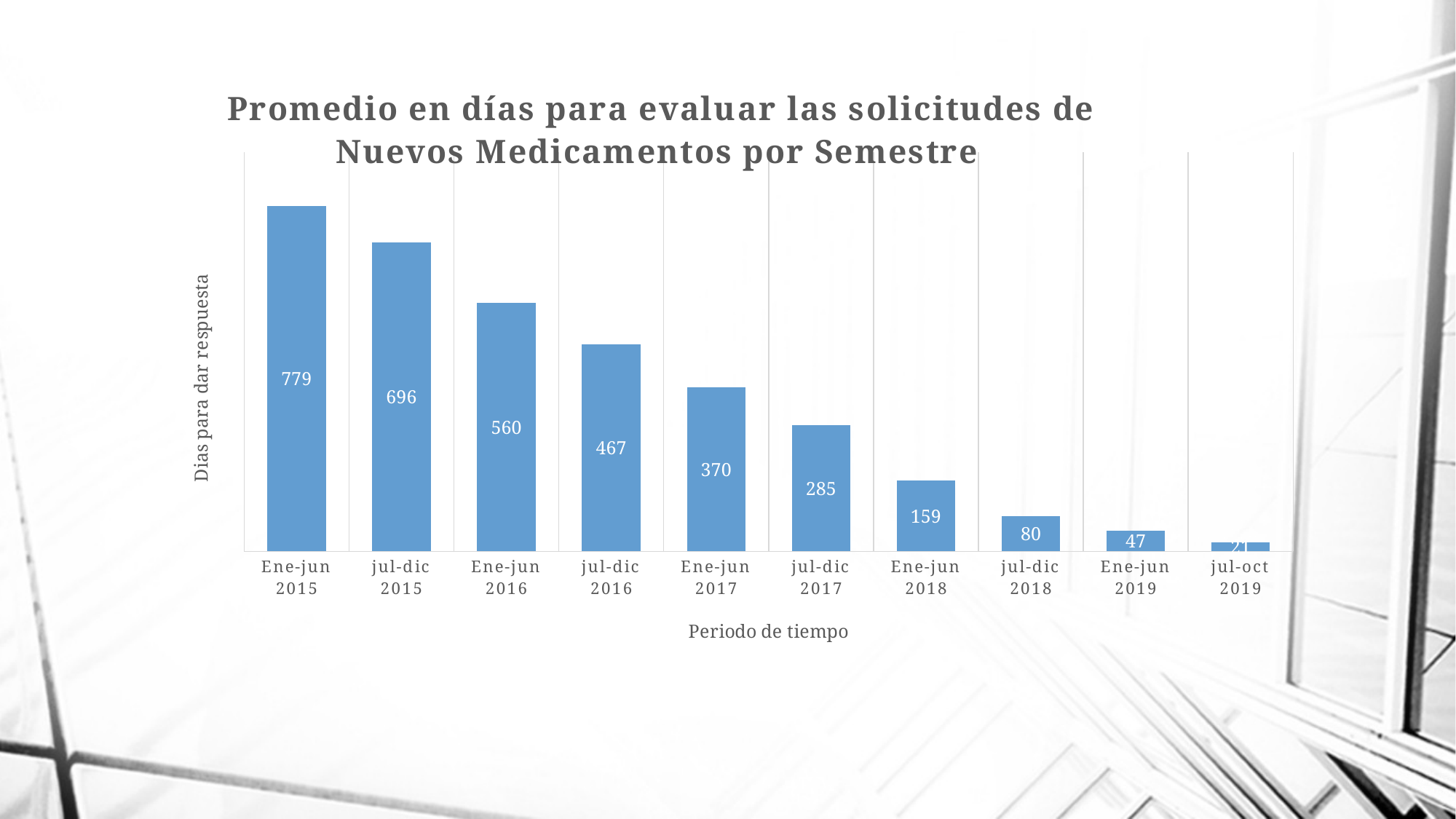
What is the difference between the values for Ene-jun 2017 and jul-dic 2017? 85 Which period has the lowest value? jul-oct 2019 What is the value for Ene-jun 2018? 159 What is the value for jul-dic 2016? 467 What kind of chart is this? bar chart Which period has the highest value? Ene-jun 2015 Do the values rise or fall from left to right along the x axis? fall What is the value for Ene-jun 2019? 47 What is the difference between the values for jul-dic 2015 and Ene-jun 2016? 136 How many periods are shown on the x axis? 10 Which is larger, the value for jul-dic 2017 or the value for jul-dic 2018? jul-dic 2017 What is the value for Ene-jun 2015? 779